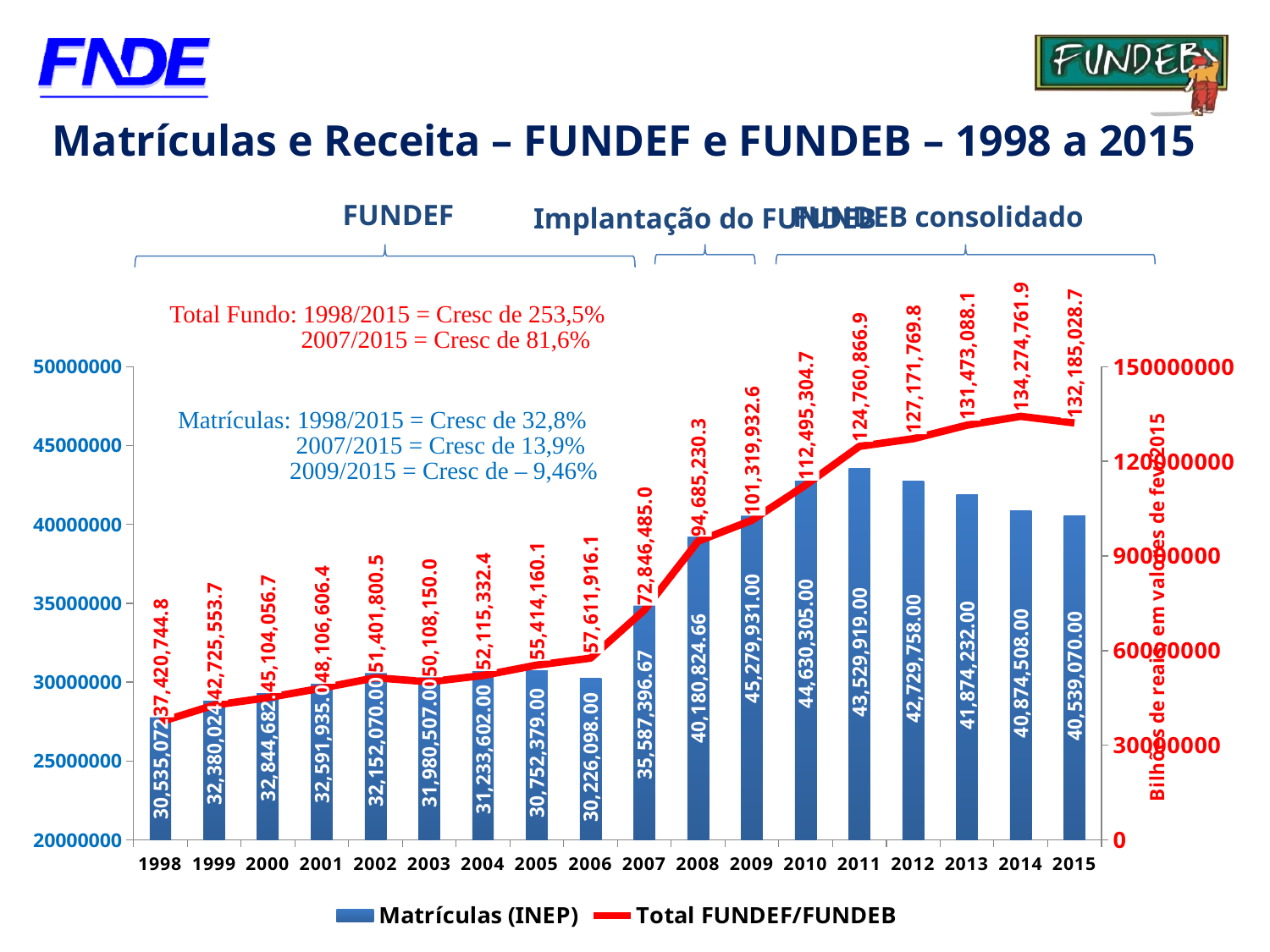
What is the value of Matrículas (INEP) for 2015? 40,539,070.00 Does Total FUNDEF/FUNDEB rise or fall from 2007 to 2014? Rise How many years are shown on the x axis? 18 In which year is Total FUNDEF/FUNDEB lowest? 1998 How many series does the legend list? 2 What is the value of Total FUNDEF/FUNDEB for 2014? 134,274,761.9 In which year is Matrículas (INEP) highest? 2009 What is the difference between Total FUNDEF/FUNDEB in 2009 and 2008? 6,634,702.3 What is the value of Matrículas (INEP) for 2009? 45,279,931.00 What kind of chart is shown on the slide? A combination bar and line chart Which year has the larger Matrículas (INEP) value, 2010 or 2011? 2010 In which year is Total FUNDEF/FUNDEB highest? 2014